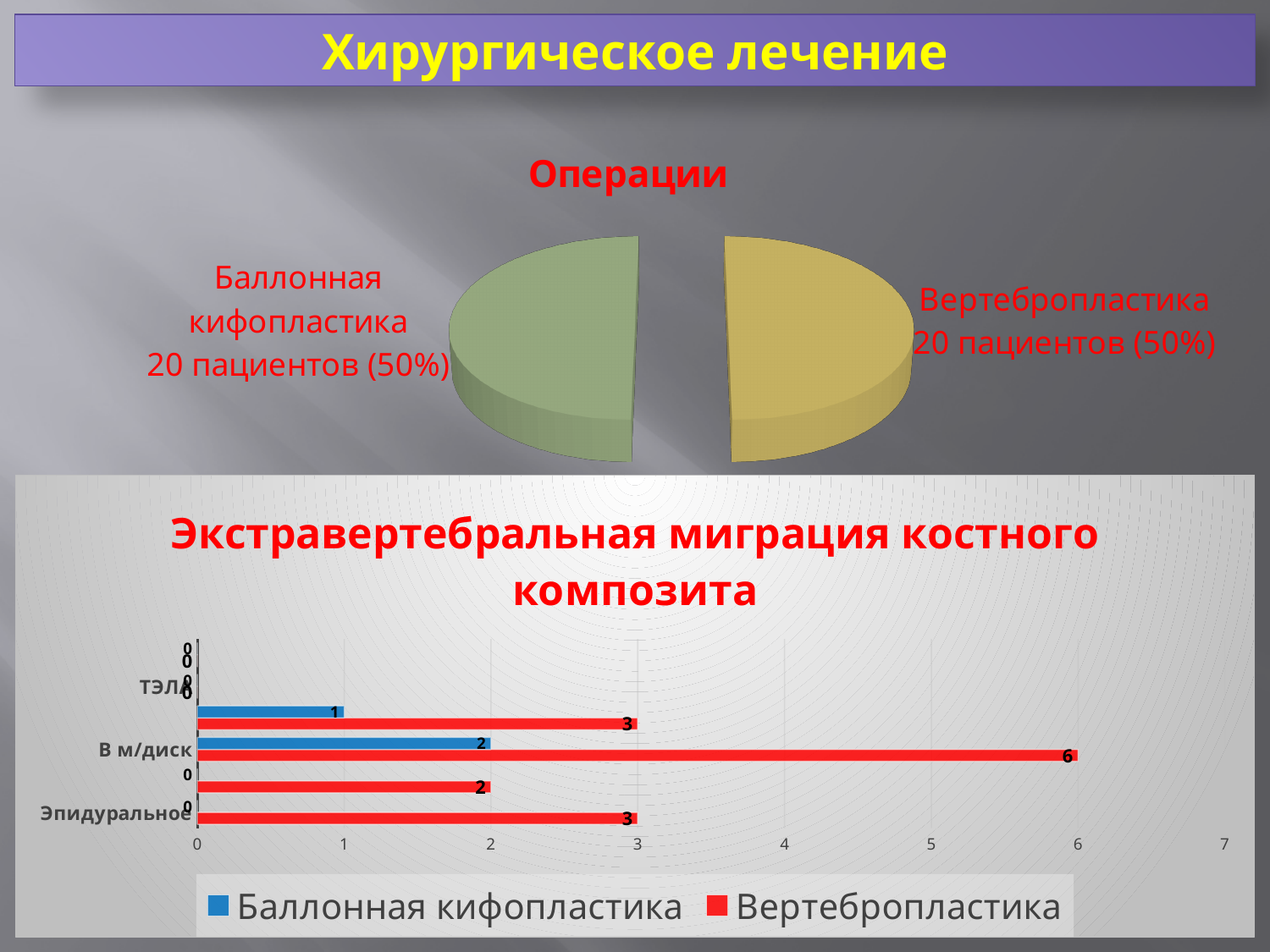
In 'Экстравертебральная миграция костного композита', what is the Вертебропластика value for Эпидуральное? 3 In the 'Операции' pie chart, what share does Вертебропластика have? 50% How many series does the legend of 'Экстравертебральная миграция костного композита' list? 2 In 'Экстравертебральная миграция костного композита', what is the difference between the Вертебропластика and Баллонная кифопластика values for В м/диск? 4 In the 'Операции' pie chart, how many patients are in the Баллонная кифопластика slice? 20 пациентов What kind of chart is the 'Операции' chart at the top of the slide? pie chart In 'Экстравертебральная миграция костного композита', which colour represents Вертебропластика in the legend? red In 'Экстравертебральная миграция костного композита', what is the Вертебропластика value for В м/диск? 6 In 'Экстравертебральная миграция костного композита', which series has the larger value for В м/диск? Вертебропластика What kind of chart is 'Экстравертебральная миграция костного композита'? bar chart How many slices does the 'Операции' pie chart have? 2 In 'Экстравертебральная миграция костного композита', what is the Баллонная кифопластика value for В м/диск? 2